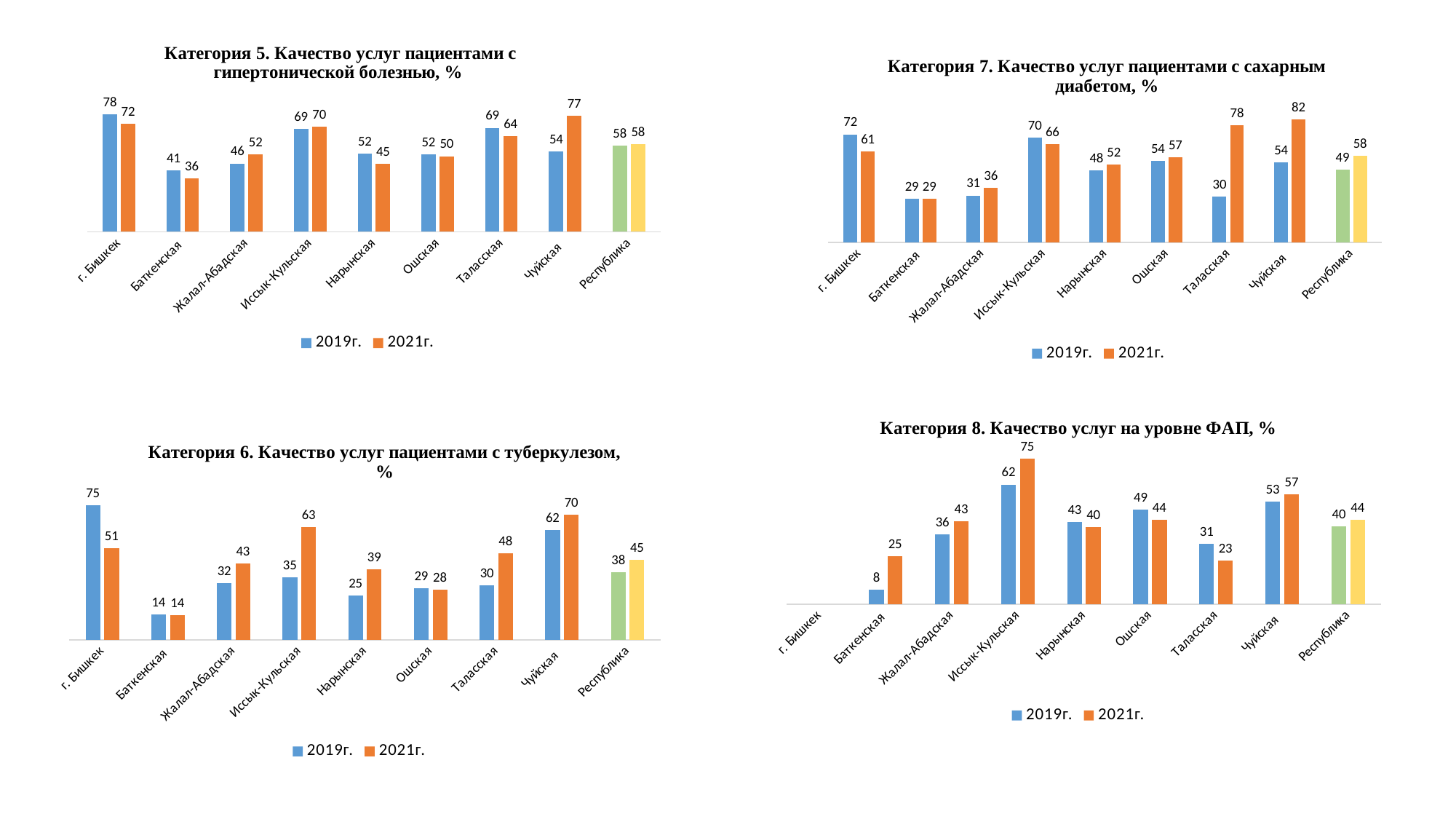
In the chart 'Категория 6. Качество услуг пациентами с туберкулезом, %', what is the difference between the 2019г. and 2021г. values for г. Бишкек? 24 In the chart 'Категория 7. Качество услуг пациентами с сахарным диабетом, %', what is the value for Таласская in 2021г.? 78 In the chart 'Категория 6. Качество услуг пациентами с туберкулезом, %', which is larger for Иссык-Кульская: the 2019г. value or the 2021г. value? 2021г. In the chart 'Категория 6. Качество услуг пациентами с туберкулезом, %', what is the value for г. Бишкек in 2019г.? 75 How many series does the legend list in the chart 'Категория 8. Качество услуг на уровне ФАП, %'? 2 In the chart 'Категория 5. Качество услуг пациентами с гипертонической болезнью, %', which region has the highest 2019г. value? г. Бишкек What type of chart is 'Категория 5. Качество услуг пациентами с гипертонической болезнью, %'? Bar chart In the chart 'Категория 7. Качество услуг пациентами с сахарным диабетом, %', what is the difference between the 2021г. and 2019г. values for Чуйская? 28 In the chart 'Категория 7. Качество услуг пациентами с сахарным диабетом, %', which region has the lowest 2021г. value? Баткенская In the chart 'Категория 8. Качество услуг на уровне ФАП, %', which region has the highest 2021г. value? Иссык-Кульская In the chart 'Категория 8. Качество услуг на уровне ФАП, %', what is the value for Баткенская in 2019г.? 8 In the chart 'Категория 5. Качество услуг пациентами с гипертонической болезнью, %', what is the value for Чуйская in 2021г.? 77